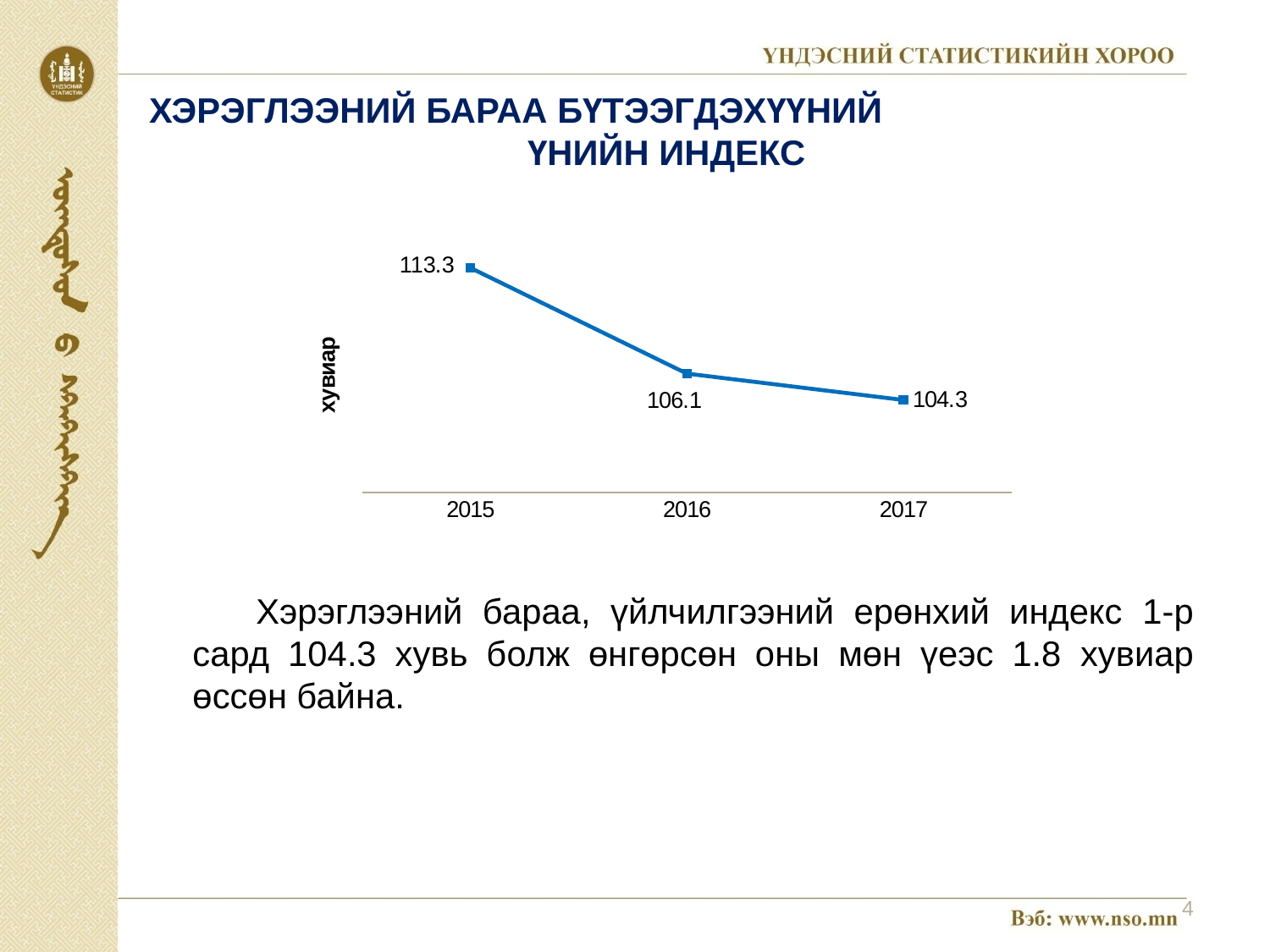
What kind of chart is shown on the slide? line chart Do the values rise or fall from 2015 to 2017? fall What is the value for 2016? 106.1 What is the difference between the values for 2016 and 2017? 1.8 Which year has the highest value? 2015 What is the value for 2017? 104.3 Which year has the lowest value? 2017 How many data points are plotted on the chart? 3 What is the label on the vertical axis of the chart? хувиар Which is larger, the value for 2015 or the value for 2017? 2015 What is the value for 2015? 113.3 What is the difference between the values for 2015 and 2016? 7.2